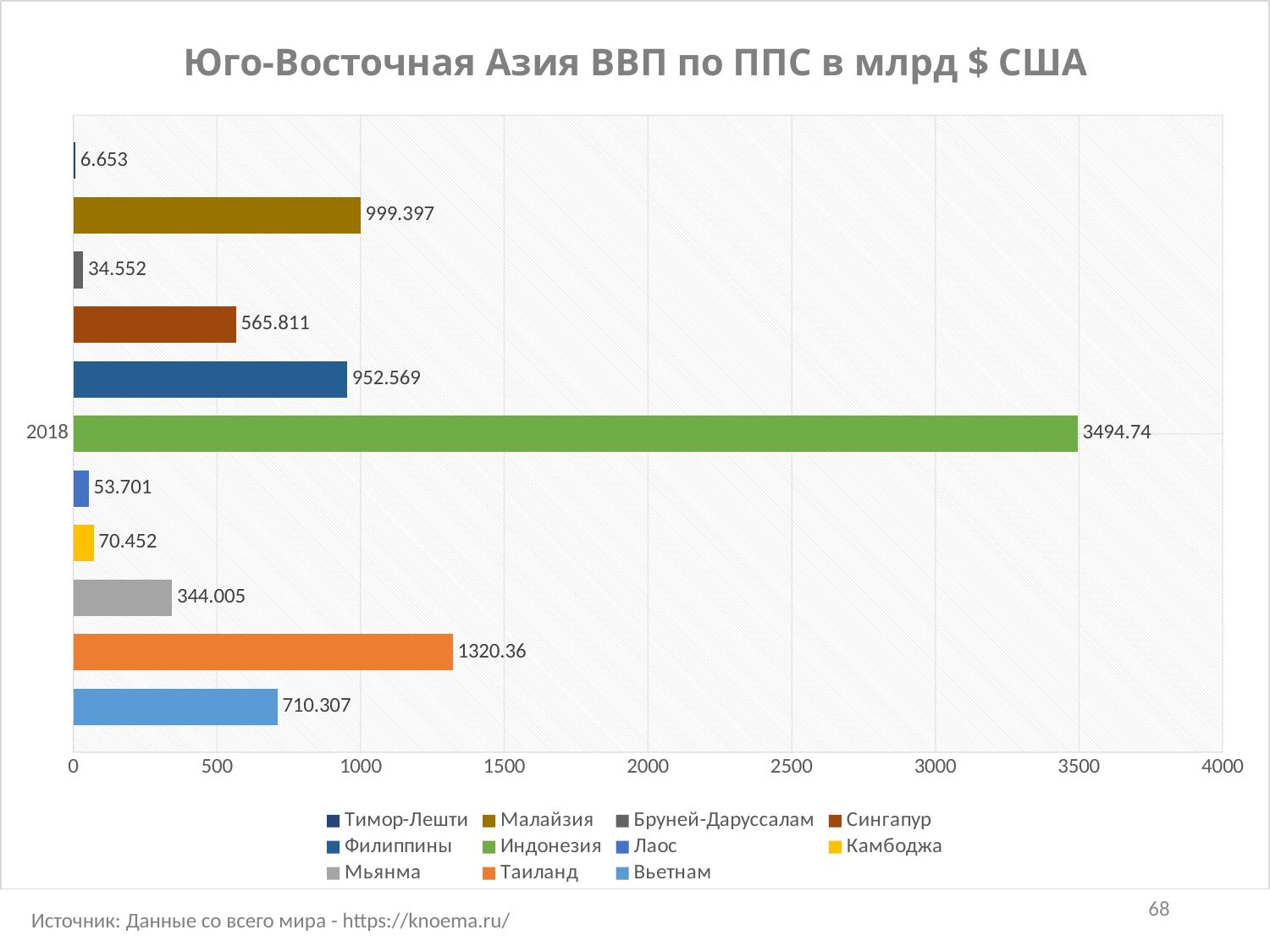
What is the value for Индонезия? 3494.74 Which country has the lowest value? Тимор-Лешти What is the difference between the values for Вьетнам and Сингапур? 144.496 What is the value for Таиланд? 1320.36 What is the title of the chart? Юго-Восточная Азия ВВП по ППС в млрд $ США What kind of chart is shown? Bar chart What is the value for Бруней-Даруссалам? 34.552 What is the value for Мьянма? 344.005 What is the difference between the values for Таиланд and Малайзия? 320.963 Which country has the highest value? Индонезия How many series does the legend list? 11 Which is larger, the value for Малайзия or the value for Филиппины? Малайзия